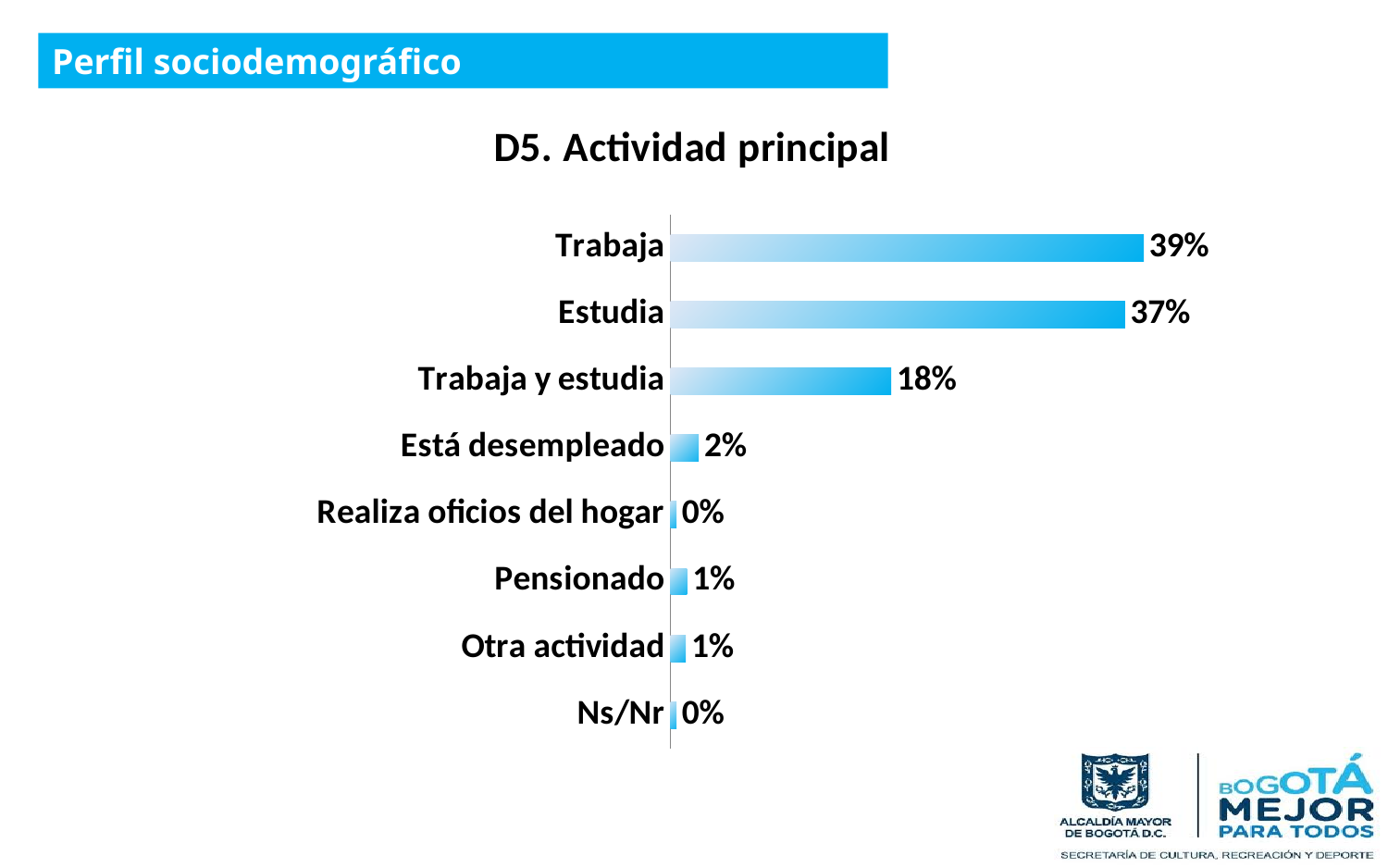
What is the value for Pensionado? 1% What is the value for Trabaja? 39% Which is larger, the value for Trabaja y estudia or the value for Está desempleado? Trabaja y estudia How many categories are shown in the chart? 8 Which category has the highest value? Trabaja What is the value for Estudia? 37% What is the title of the chart? D5. Actividad principal What is the difference between the values for Estudia and Trabaja y estudia? 19% What is the difference between the values for Trabaja and Estudia? 2% What is the value for Trabaja y estudia? 18% What is the value for Está desempleado? 2% What kind of chart is shown on the slide? Bar chart